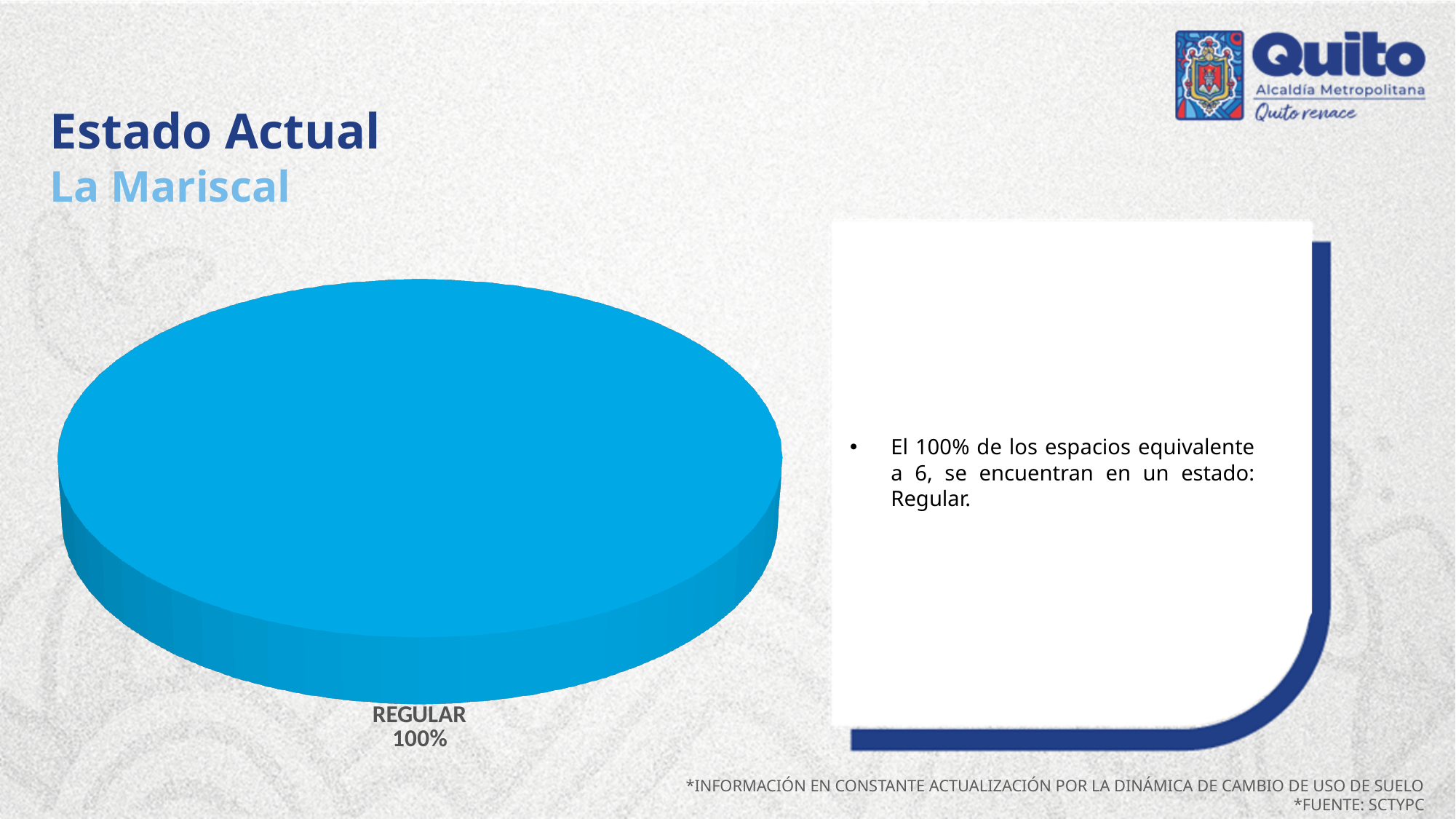
What is the label of the only slice in the pie chart? REGULAR How many slices does the pie chart have? 1 Which category is the largest slice in the pie chart? REGULAR What is the value shown for the REGULAR category in the pie chart? 100% What colour is the REGULAR slice in the pie chart? blue What share of the pie does the REGULAR slice represent? 100% What kind of chart is shown on the slide? pie chart